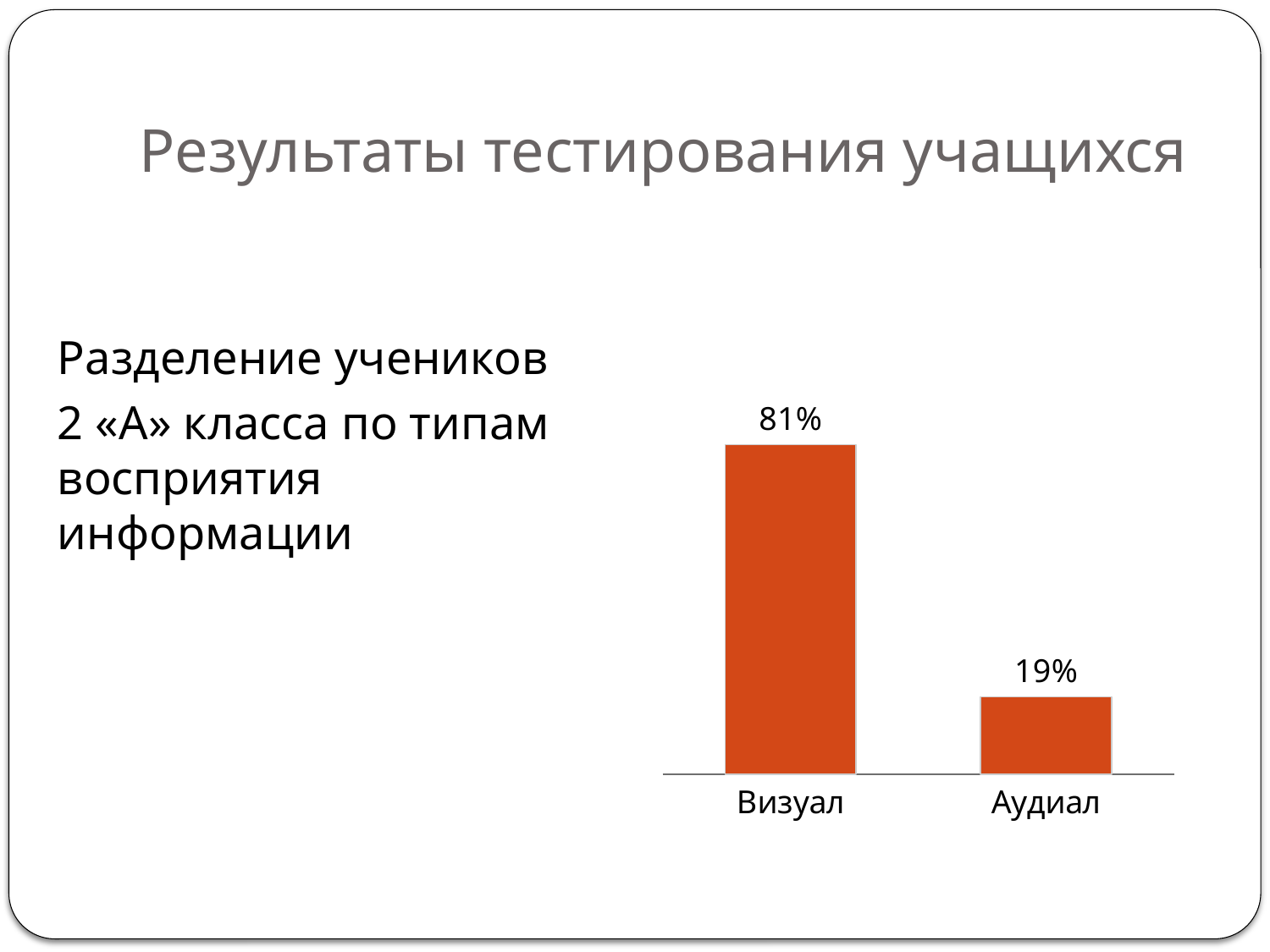
What kind of chart is shown on the slide? Bar chart What is the value for Аудиал? 19% How many categories are shown in the chart? 2 What colour are the bars in the chart? Orange-red What is the value for Визуал? 81% What is the title of the slide? Результаты тестирования учащихся Which category has the lowest value? Аудиал Which is larger, the value for Визуал or the value for Аудиал? Визуал Which category has the highest value? Визуал What is the difference between the values for Визуал and Аудиал? 62% What is the total of the two values shown in the chart? 100%